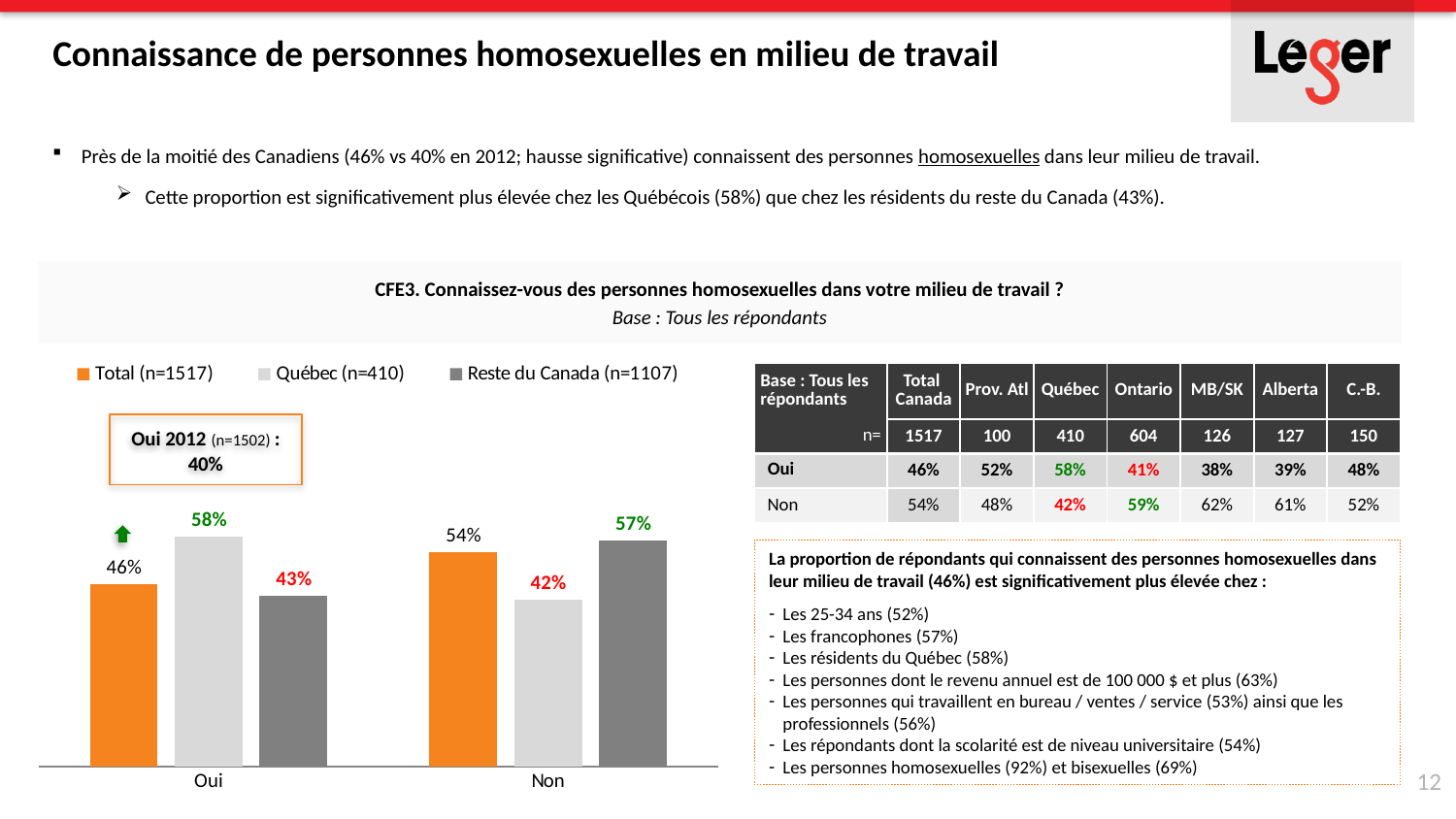
How many categories are shown on the x axis of the chart? 2 What is the value for Québec (n=410) in the Non category? 42% Which is larger: the Total (n=1517) value for Oui or the Total (n=1517) value for Non? Non What is the difference between the Québec (n=410) and Reste du Canada (n=1107) values in the Oui category? 15% How many series does the chart legend list? 3 What value does the 'Oui 2012 (n=1502)' callout box on the chart show? 40% Which series has the highest value in the Oui category? Québec (n=410) What is the value for Québec (n=410) in the Oui category? 58% What is the value for Total (n=1517) in the Oui category? 46% Which series has the lowest value in the Non category? Québec (n=410) What is the value for Reste du Canada (n=1107) in the Non category? 57% What kind of chart is shown on the slide? bar chart